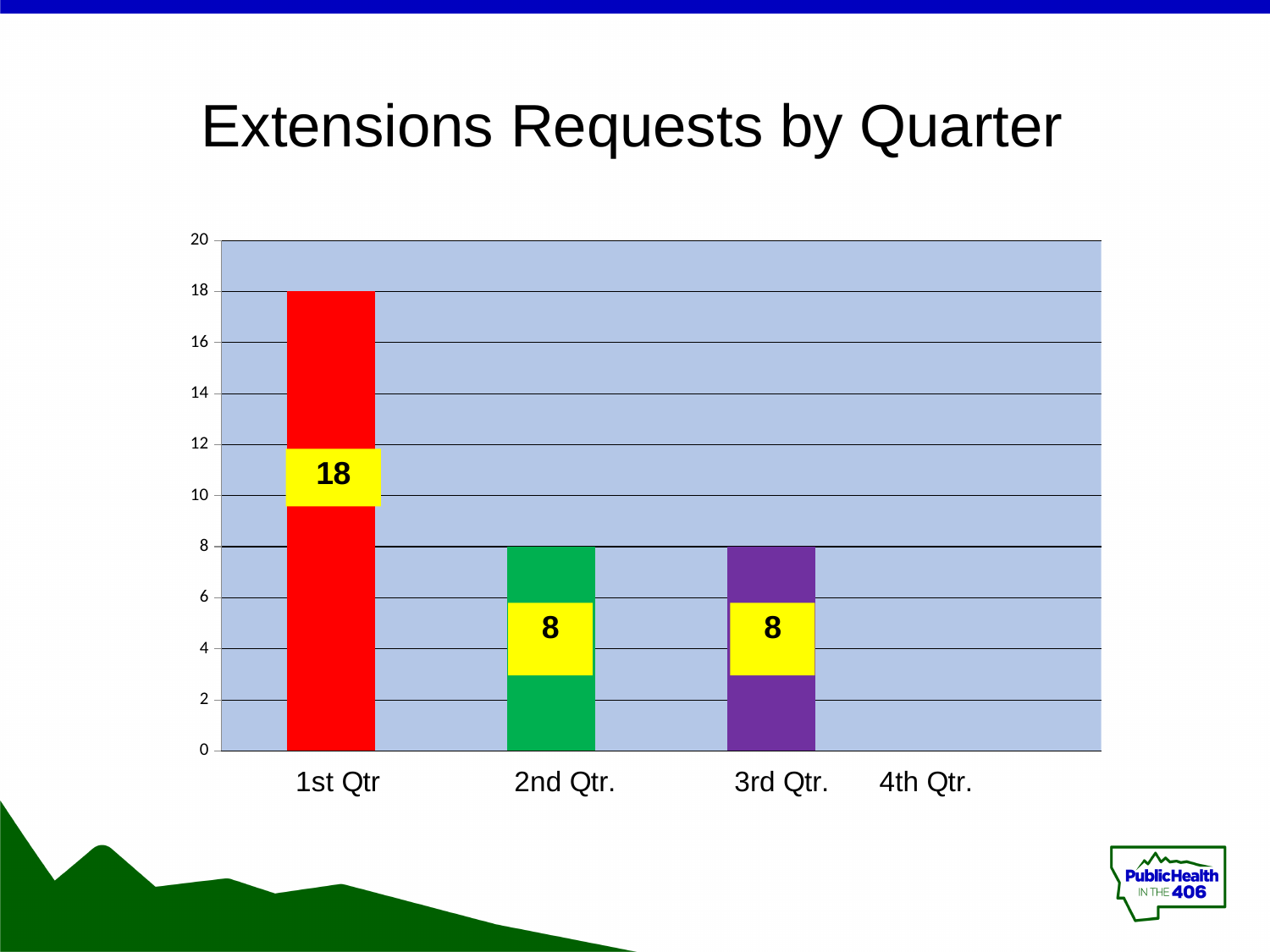
What is the value for 1st Qtr? 18 Which is larger, the value for 1st Qtr or the value for 3rd Qtr.? 1st Qtr What is the difference between the values for 1st Qtr and 2nd Qtr.? 10 Which quarter has the highest value? 1st Qtr What is the value for 3rd Qtr.? 8 How many quarter categories are shown on the x axis? 4 What is the value for 2nd Qtr.? 8 What colour is the bar for 1st Qtr? red What kind of chart is shown on the slide? bar chart Is the value for 2nd Qtr. greater or less than 10? less Is the value for 1st Qtr greater or less than 10? greater What is the title of the chart? Extensions Requests by Quarter